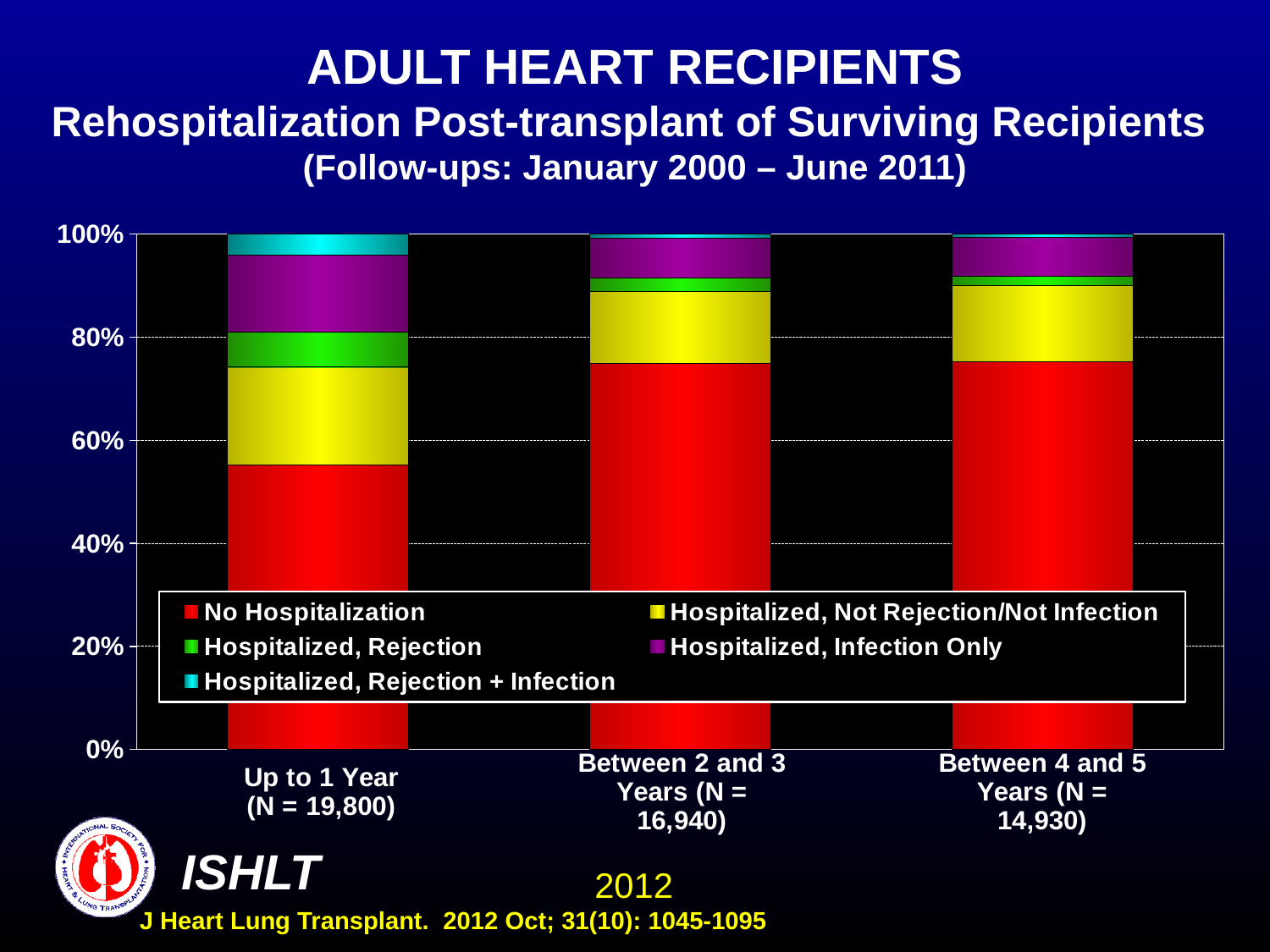
What is the N shown for the Up to 1 Year category? 19,800 Is the No Hospitalization share for Up to 1 Year greater or less than 40%? greater Which follow-up category has the smallest No Hospitalization share? Up to 1 Year How many series does the legend list? 5 Is the No Hospitalization share for Between 2 and 3 Years greater or less than 60%? greater What kind of chart is shown on the slide? Stacked bar chart Does the No Hospitalization share rise or fall from Up to 1 Year to Between 2 and 3 Years? rise Is the No Hospitalization share for Between 4 and 5 Years greater or less than 80%? less Which has the larger Hospitalized, Infection Only segment: Up to 1 Year or Between 4 and 5 Years? Up to 1 Year Which has the larger No Hospitalization share: Up to 1 Year or Between 2 and 3 Years? Between 2 and 3 Years How many follow-up time categories are shown on the x axis? 3